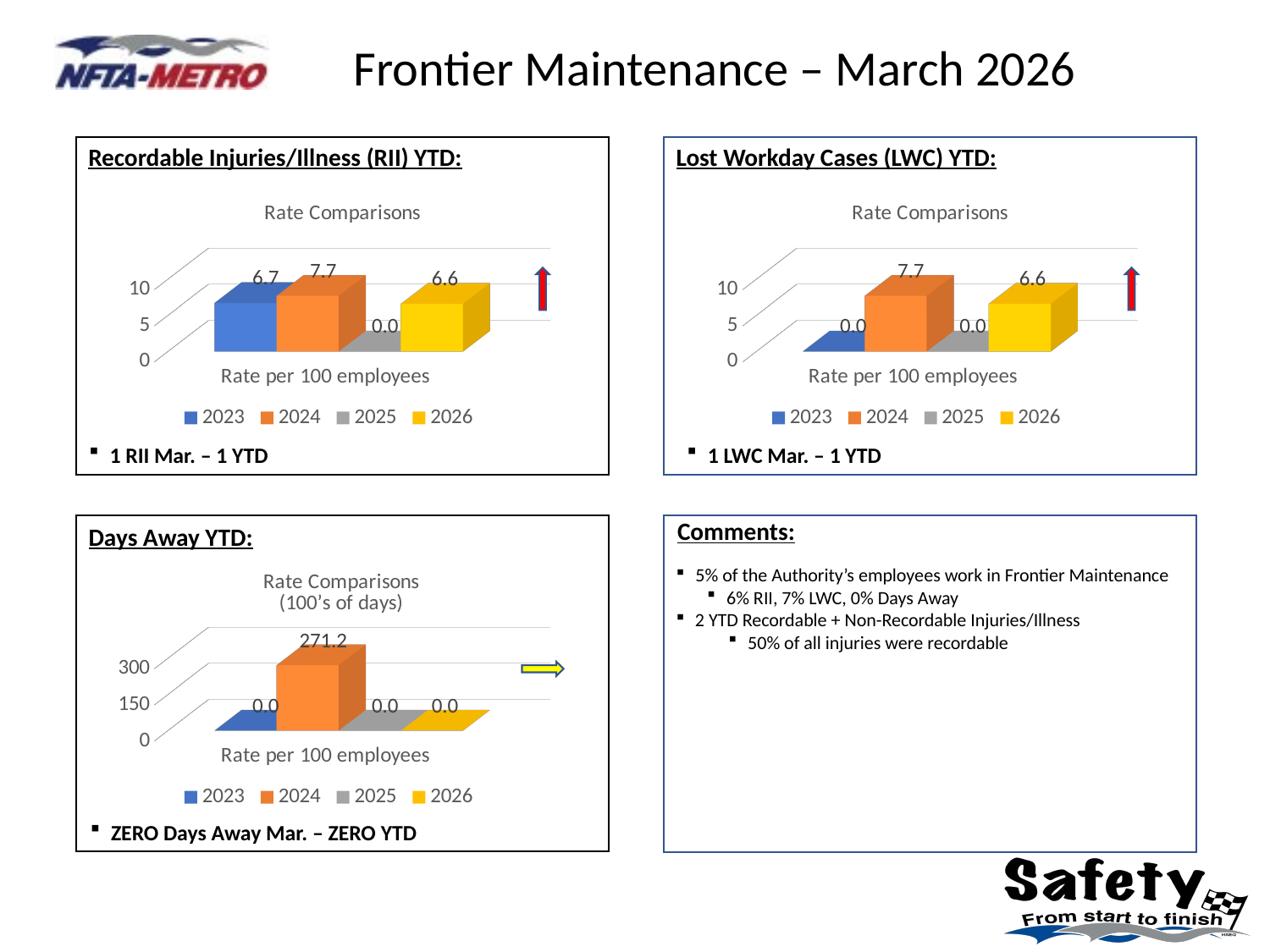
What kind of chart is the Days Away YTD chart? Bar chart In the Recordable Injuries/Illness (RII) YTD chart, what is the value for 2026? 6.6 In the Days Away YTD chart, which year has the highest value? 2024 In the Lost Workday Cases (LWC) YTD chart, what is the value for 2023? 0.0 How many series does the legend of the Recordable Injuries/Illness (RII) YTD chart list? 4 In the Days Away YTD chart, what is the value for 2024? 271.2 In the Recordable Injuries/Illness (RII) YTD chart, what is the value for 2023? 6.7 In the Lost Workday Cases (LWC) YTD chart, what is the value for 2024? 7.7 In the Recordable Injuries/Illness (RII) YTD chart, what is the difference between the 2024 and 2023 values? 1.0 In the Lost Workday Cases (LWC) YTD chart, which is larger, the value for 2024 or the value for 2026? 2024 In the Recordable Injuries/Illness (RII) YTD chart, which year has the highest value? 2024 In the Days Away YTD chart, what is the value for 2026? 0.0